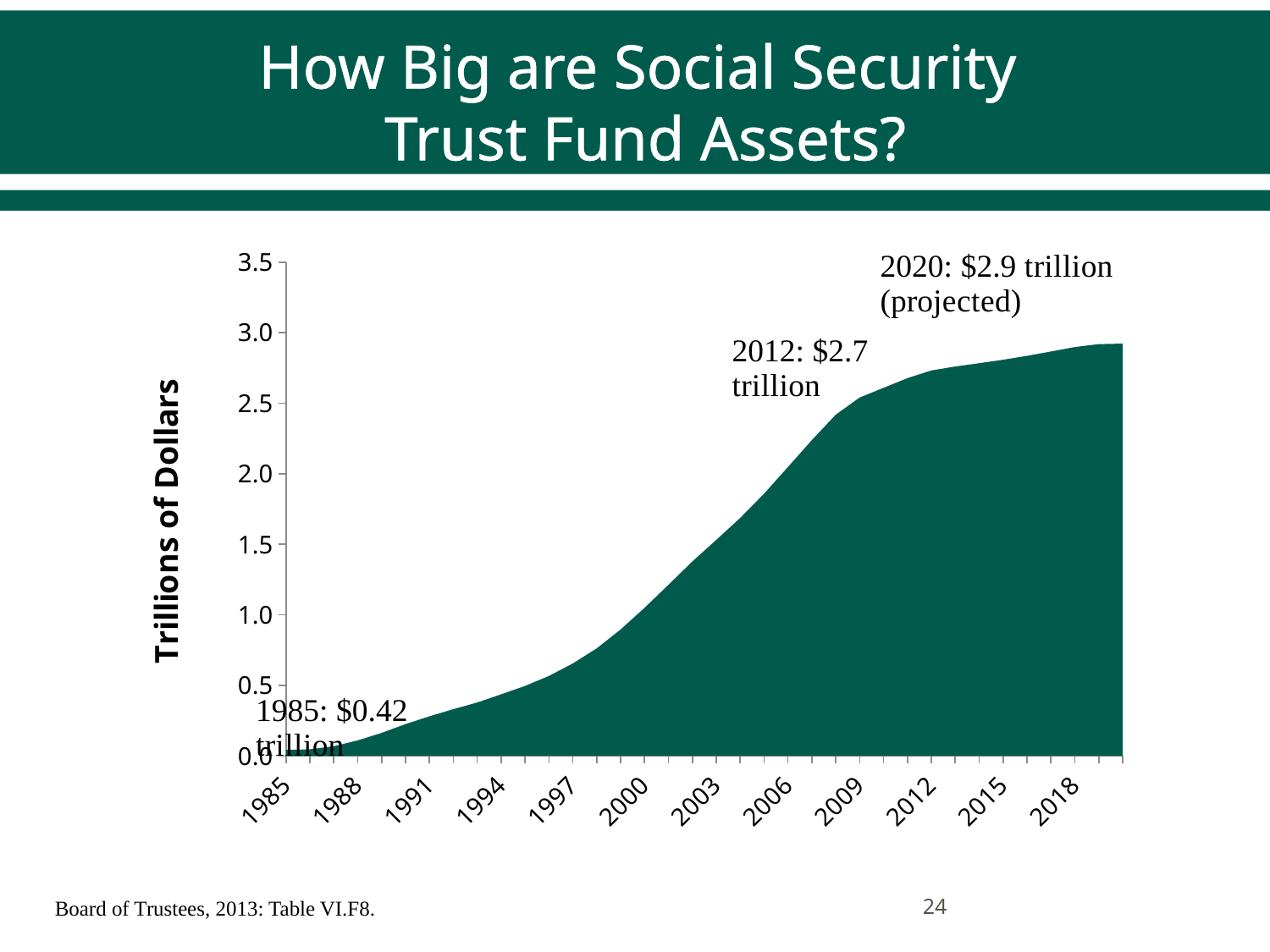
What is the difference between the annotated 2020 projected value and the 2012 value? $0.2 trillion What is the projected value of Social Security Trust Fund assets in 2020, according to the chart annotation? $2.9 trillion Which year has larger trust fund assets, 1985 or 2012? 2012 What was the value of Social Security Trust Fund assets in 2012, according to the chart annotation? $2.7 trillion Is the value for 2003 greater or less than 1.0 trillion dollars? greater By how much did trust fund assets grow between 1985 and 2012, using the annotated values? $2.28 trillion Is the value for 1991 greater or less than 0.5 trillion dollars? less Is the value for 2009 greater or less than 2.0 trillion dollars? greater What kind of chart is shown on the slide? Area chart Do trust fund assets rise or fall from 1985 to 2020 in the chart? Rise What is the label on the vertical axis of the chart? Trillions of Dollars What was the value of Social Security Trust Fund assets in 1985, according to the chart annotation? $0.42 trillion